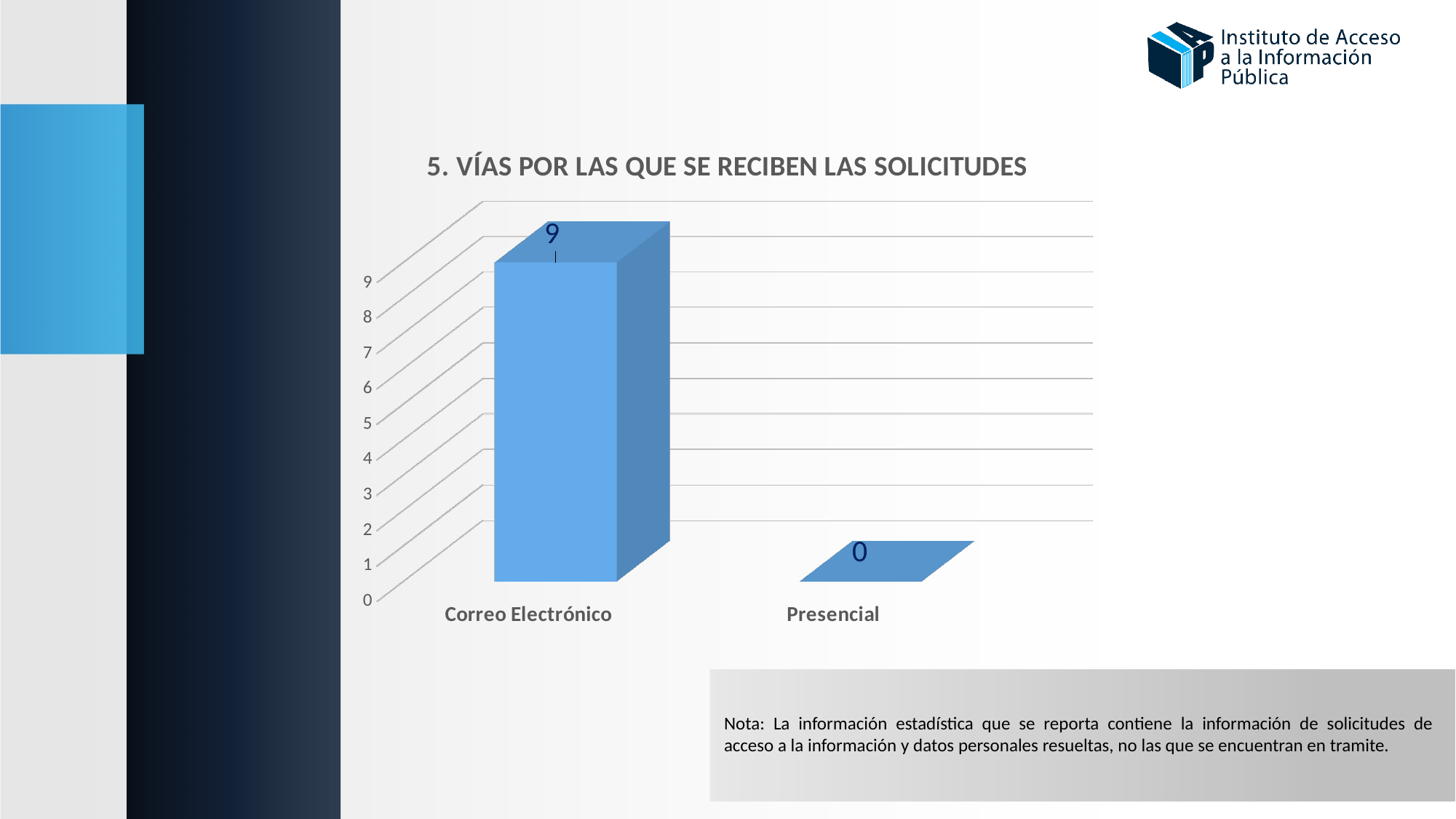
What is the value for Presencial? 0 What kind of chart is shown on the slide? bar chart Which category has the lowest value? Presencial What is the difference between the values for Correo Electrónico and Presencial? 9 Which category has the highest value? Correo Electrónico What is the highest value shown on the vertical axis? 9 What is the total of the values for Correo Electrónico and Presencial? 9 Is the value for Correo Electrónico greater or less than 5? greater How many categories are shown on the x axis? 2 Which is larger, the value for Correo Electrónico or the value for Presencial? Correo Electrónico What is the title of the chart? 5. VÍAS POR LAS QUE SE RECIBEN LAS SOLICITUDES What is the value for Correo Electrónico? 9